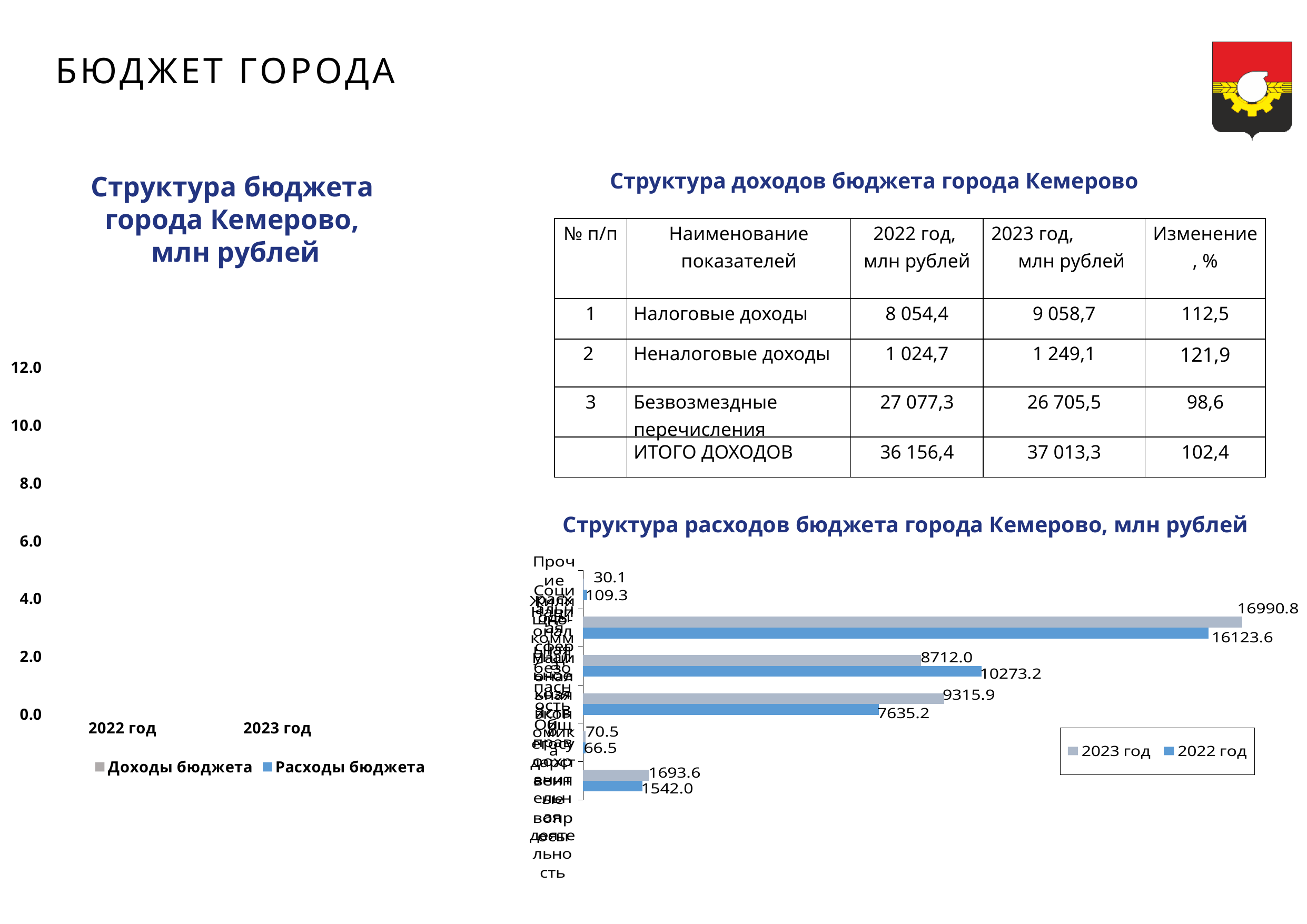
In the chart "Структура расходов бюджета города Кемерово, млн рублей", what is the smallest data label shown? 30.1 In the chart "Структура расходов бюджета города Кемерово, млн рублей", for the pair of bars labelled 8712.0 and 10273.2, what is the difference between the two values? 1561.2 In the chart "Структура расходов бюджета города Кемерово, млн рублей", what is the largest value shown for the 2022 год series? 16123.6 What kind of chart is "Структура расходов бюджета города Кемерово, млн рублей"? bar chart In the chart "Структура расходов бюджета города Кемерово, млн рублей", for the pair of bars labelled 9315.9 and 7635.2, which series has the larger value? 2023 год How many series does the legend of the left chart "Структура бюджета города Кемерово, млн рублей" list? 2 In the chart "Структура расходов бюджета города Кемерово, млн рублей", what is the 2022 год value in the bottom pair of bars? 1542.0 In the chart "Структура расходов бюджета города Кемерово, млн рублей", what is the difference between the largest 2023 год value (16990.8) and the largest 2022 год value (16123.6)? 867.2 What are the two legend entries of the chart "Структура расходов бюджета города Кемерово, млн рублей"? 2023 год, 2022 год How many series does the legend of the chart "Структура расходов бюджета города Кемерово, млн рублей" list? 2 In the chart "Структура расходов бюджета города Кемерово, млн рублей", what is the largest value shown for the 2023 год series? 16990.8 How many pairs of bars (categories) are plotted in the chart "Структура расходов бюджета города Кемерово, млн рублей"? 6